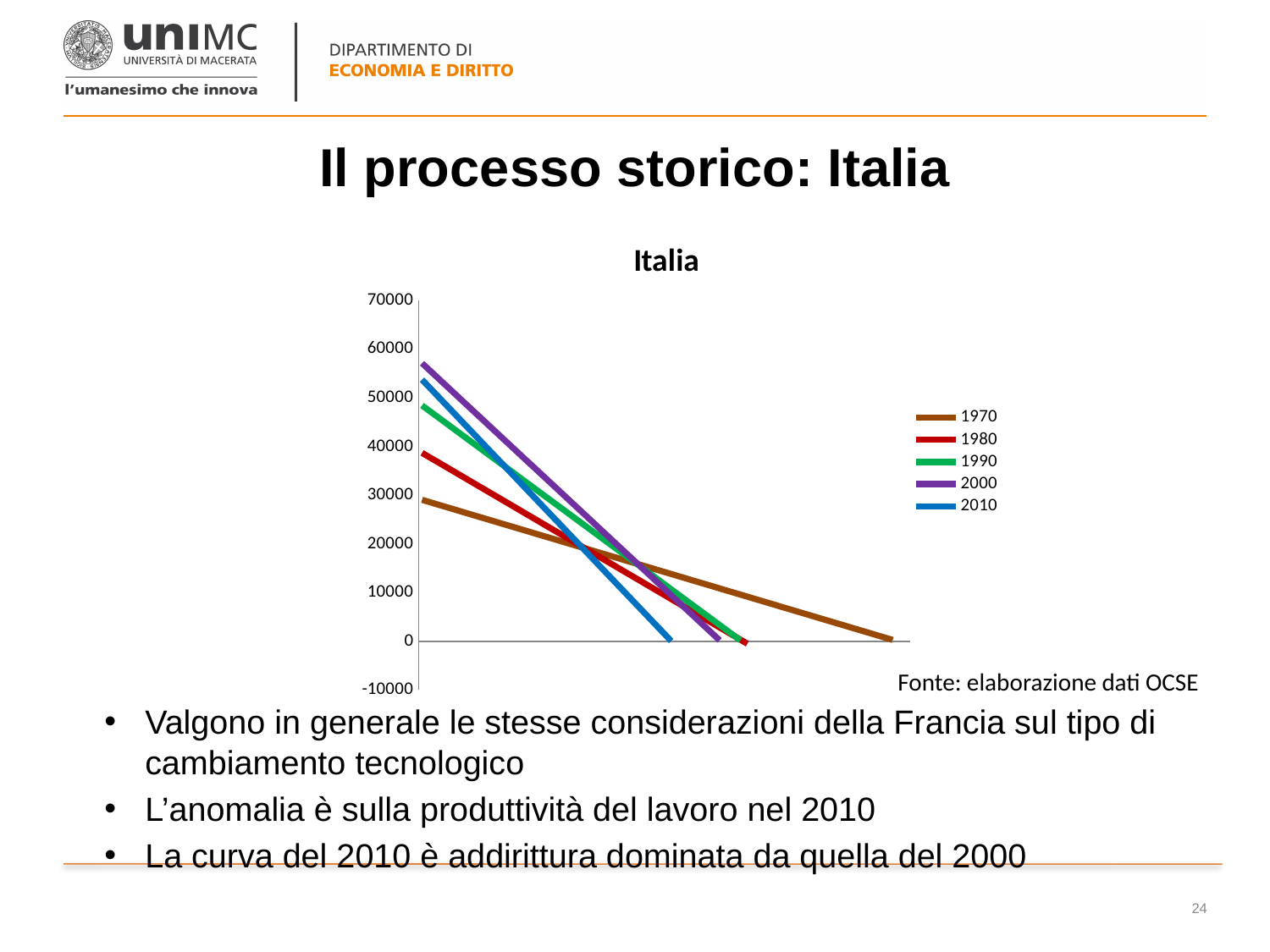
Which years are listed in the chart legend? 1970, 1980, 1990, 2000, 2010 Do the lines rise or fall from left to right? Fall Which series starts at the lowest value on the vertical axis? 1970 Is the starting value of the 2000 line greater or less than 50000? greater Is the starting value of the 1990 line greater or less than 50000? less Which starts higher on the vertical axis, the 2010 line or the 1980 line? 2010 Is the starting value of the 1980 line greater or less than 40000? less Which line reaches zero furthest to the right along the horizontal axis? 1970 Which series starts at the highest value on the vertical axis? 2000 What kind of chart is shown on the slide? Line chart What is the title of the chart? Italia How many series does the legend list? 5